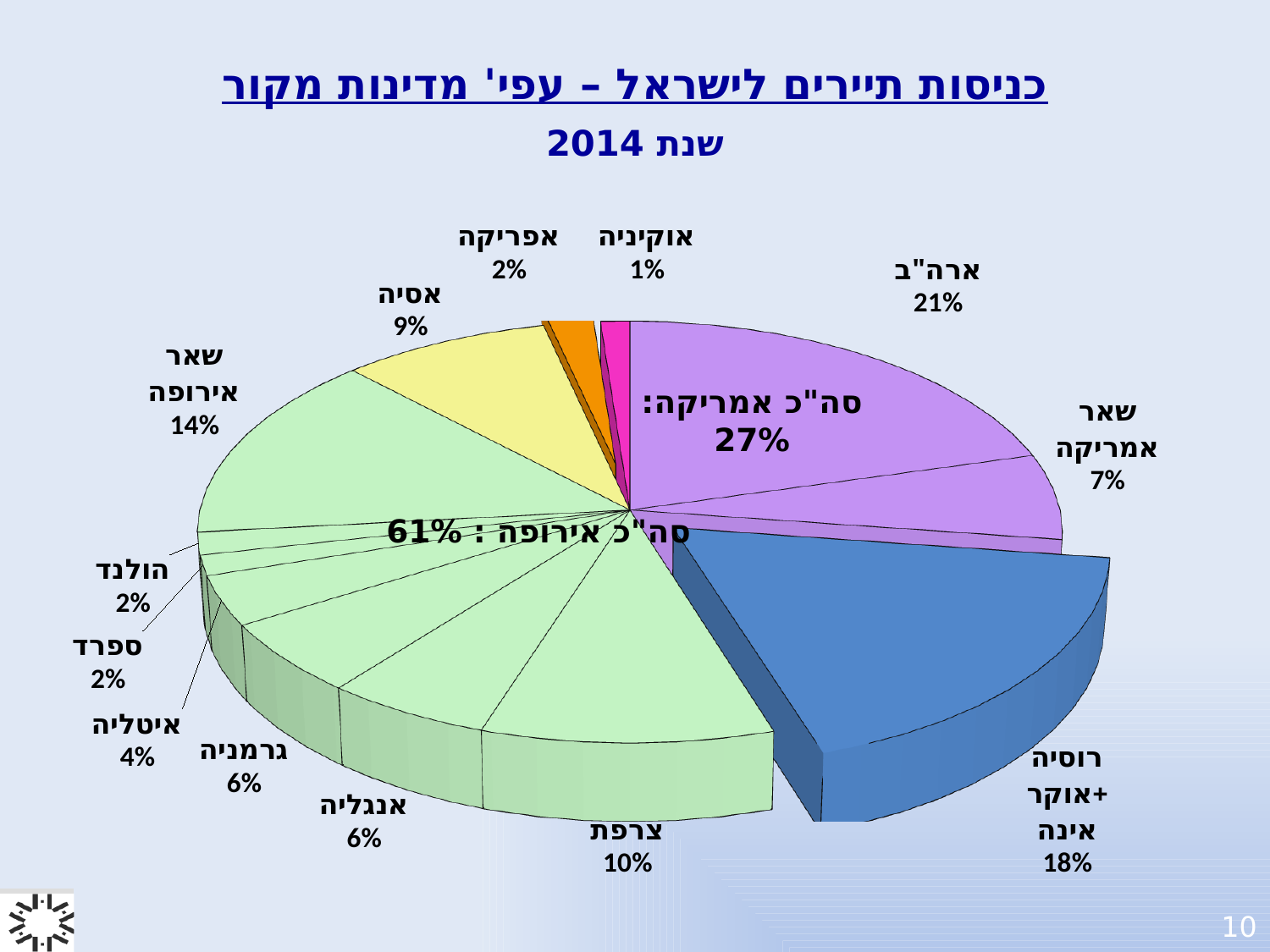
What total share is given for סה"כ אירופה on the chart? 61% Which category has the smallest slice of the pie? אוקיניה What is the value for שאר אירופה? 14% How many slices does the pie chart have? 13 Which category has the largest slice of the pie? ארה"ב What is the difference between the shares of ארה"ב and רוסיה+אוקראינה? 3% What type of chart is shown on the slide? pie chart Which is larger, the share for אסיה or the share for שאר אמריקה? אסיה What share of tourist entries does ארה"ב account for? 21% What is the value shown for רוסיה+אוקראינה? 18% Which year does the chart title refer to? 2014 What percentage is shown for צרפת? 10%